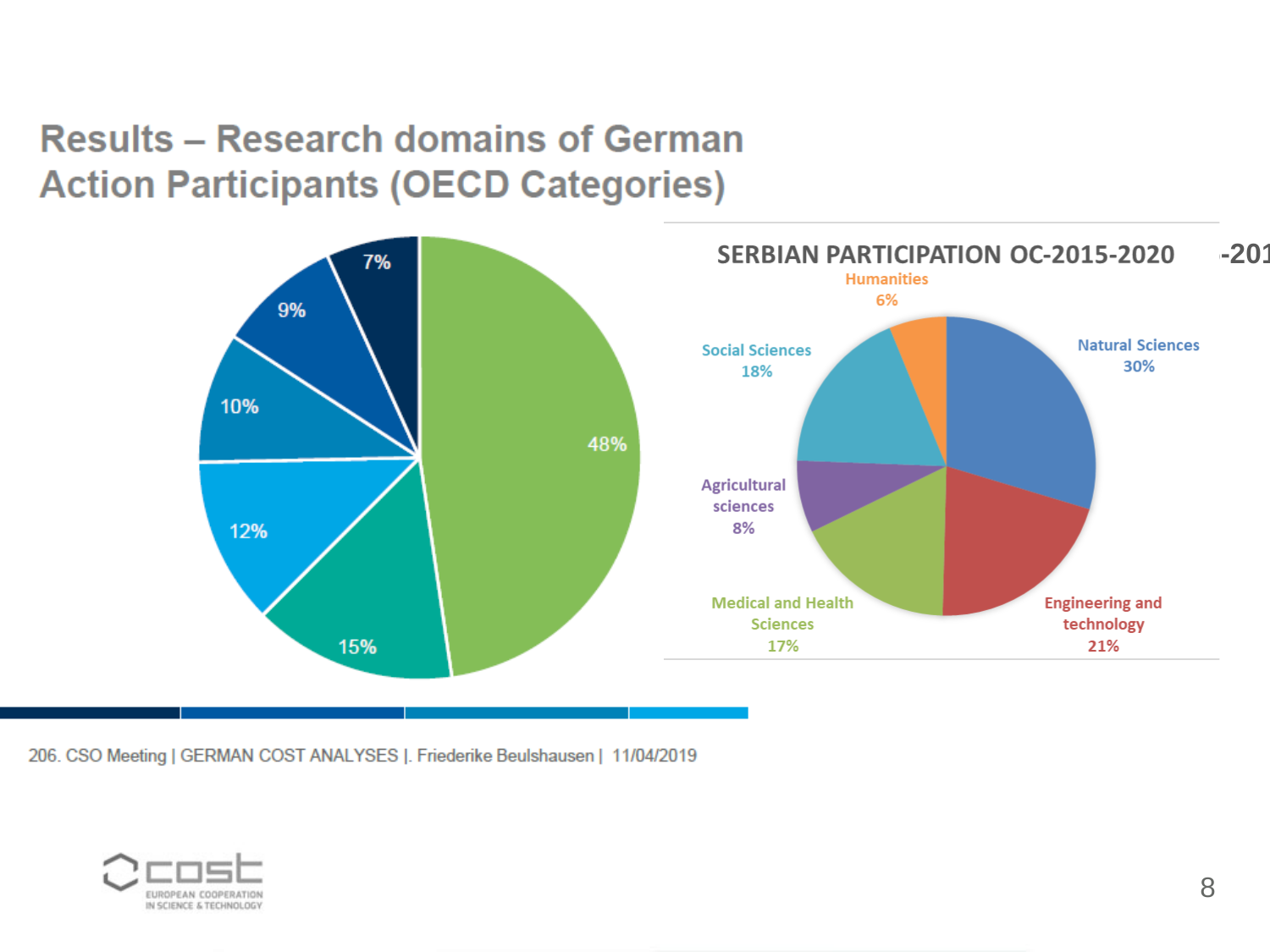
How many categories are shown in the Serbian Participation OC-2015-2020 pie chart? 6 What kind of chart is the chart on the left of the slide? Pie chart How many slices does the pie chart on the left of the slide have? 6 In the Serbian Participation OC-2015-2020 pie chart, what share does Engineering and technology have? 21% In the pie chart on the left of the slide, what is the percentage of the smallest slice? 7% In the Serbian Participation OC-2015-2020 pie chart, what share does Agricultural sciences have? 8% In the Serbian Participation OC-2015-2020 pie chart, which category has the smallest share? Humanities In the Serbian Participation OC-2015-2020 pie chart, what is the difference between the Social Sciences share and the Medical and Health Sciences share? 1% In the pie chart on the left of the slide, what is the percentage of the largest slice? 48% In the Serbian Participation OC-2015-2020 pie chart, which category has the largest share? Natural Sciences In the Serbian Participation OC-2015-2020 pie chart, what share does Natural Sciences have? 30% In the Serbian Participation OC-2015-2020 pie chart, which is larger: Engineering and technology or Social Sciences? Engineering and technology